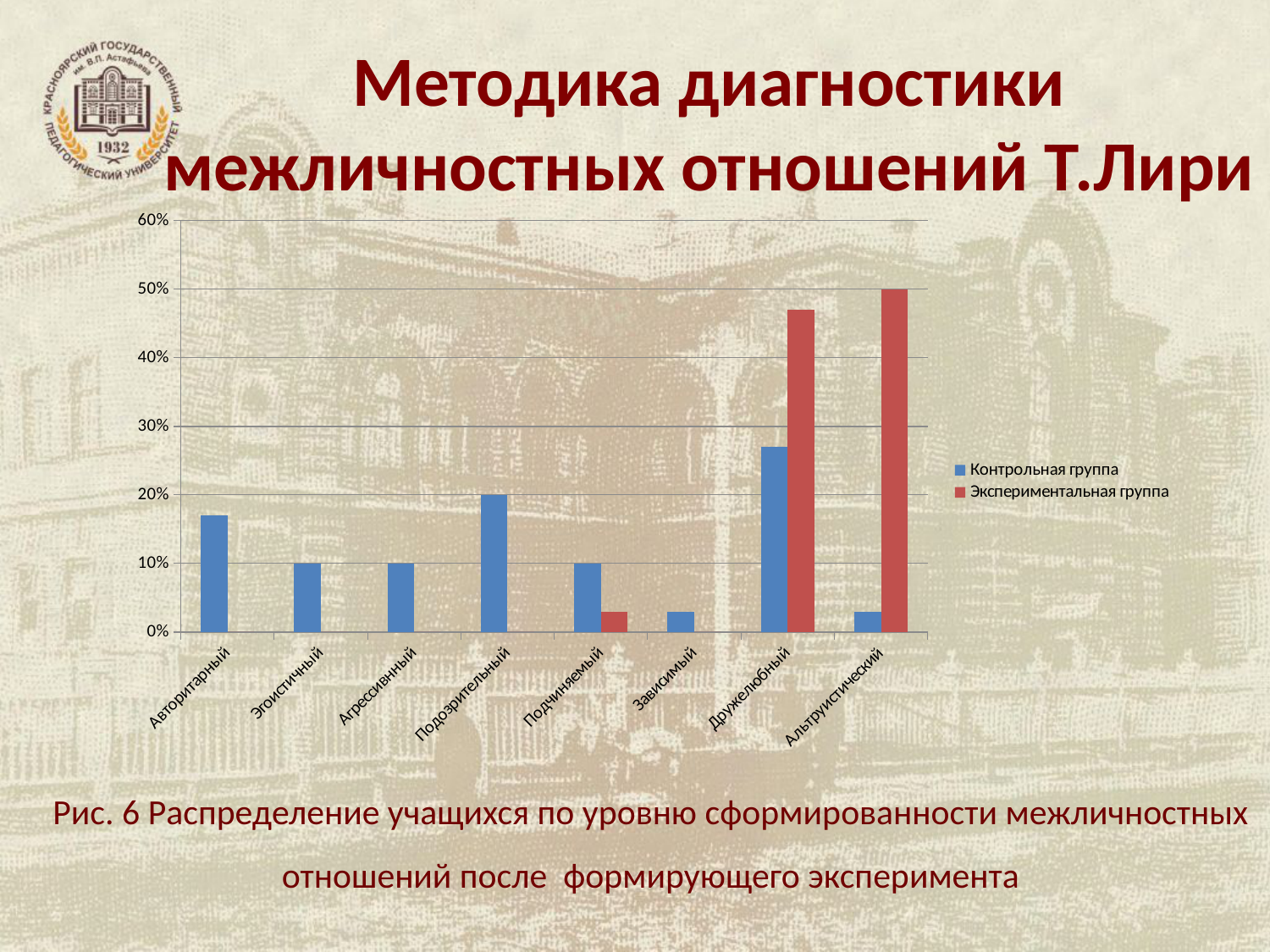
What is the value for Альтруистический in the Экспериментальная группа series? 50% Which category has the highest value in the Контрольная группа series? Дружелюбный What kind of chart is shown on the slide? bar chart Is the value for Зависимый in the Контрольная группа series greater or less than 10%? less For Дружелюбный, which series has the larger value: Контрольная группа or Экспериментальная группа? Экспериментальная группа Is the value for Авторитарный in the Контрольная группа series greater or less than 10%? greater Which series is shown in red in the chart legend? Экспериментальная группа How many series does the chart legend list? 2 Is the value for Дружелюбный in the Экспериментальная группа series greater or less than 40%? greater How many categories are shown along the x axis of the chart? 8 What is the value for Подозрительный in the Контрольная группа series? 20% What is the value for Эгоистичный in the Контрольная группа series? 10%